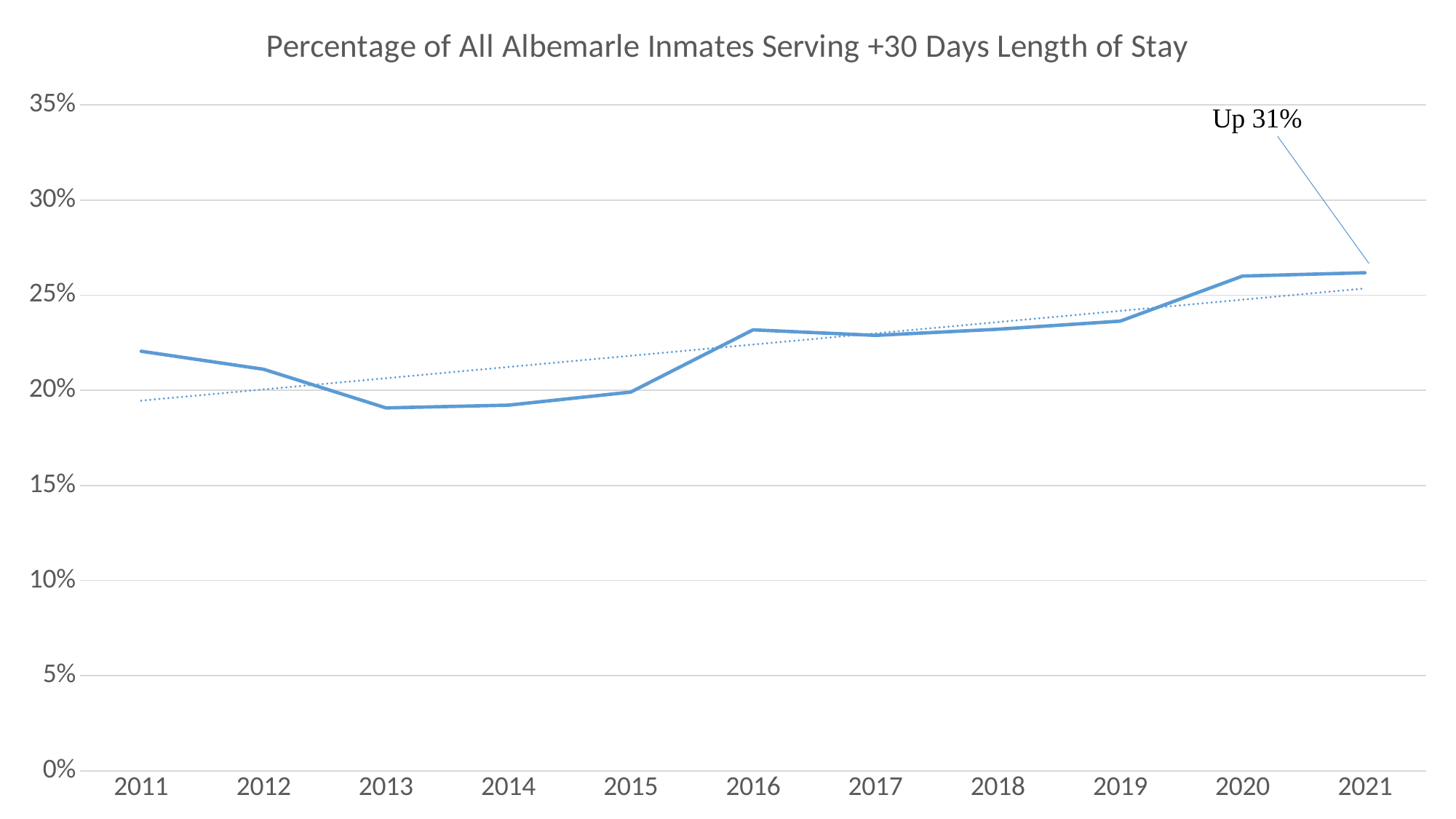
Is the value for 2019 greater or less than 25%? less Is the value for 2021 greater or less than 30%? less Is the value for 2020 greater or less than 25%? greater What does the annotation near the 2021 point say? Up 31% What is the title of the chart? Percentage of All Albemarle Inmates Serving +30 Days Length of Stay Which year has the larger value, 2015 or 2016? 2016 Which year has the larger value, 2011 or 2013? 2011 Overall, do the values rise or fall from 2011 to 2021? rise What kind of chart is shown on the slide? line chart How many years are plotted along the x axis? 11